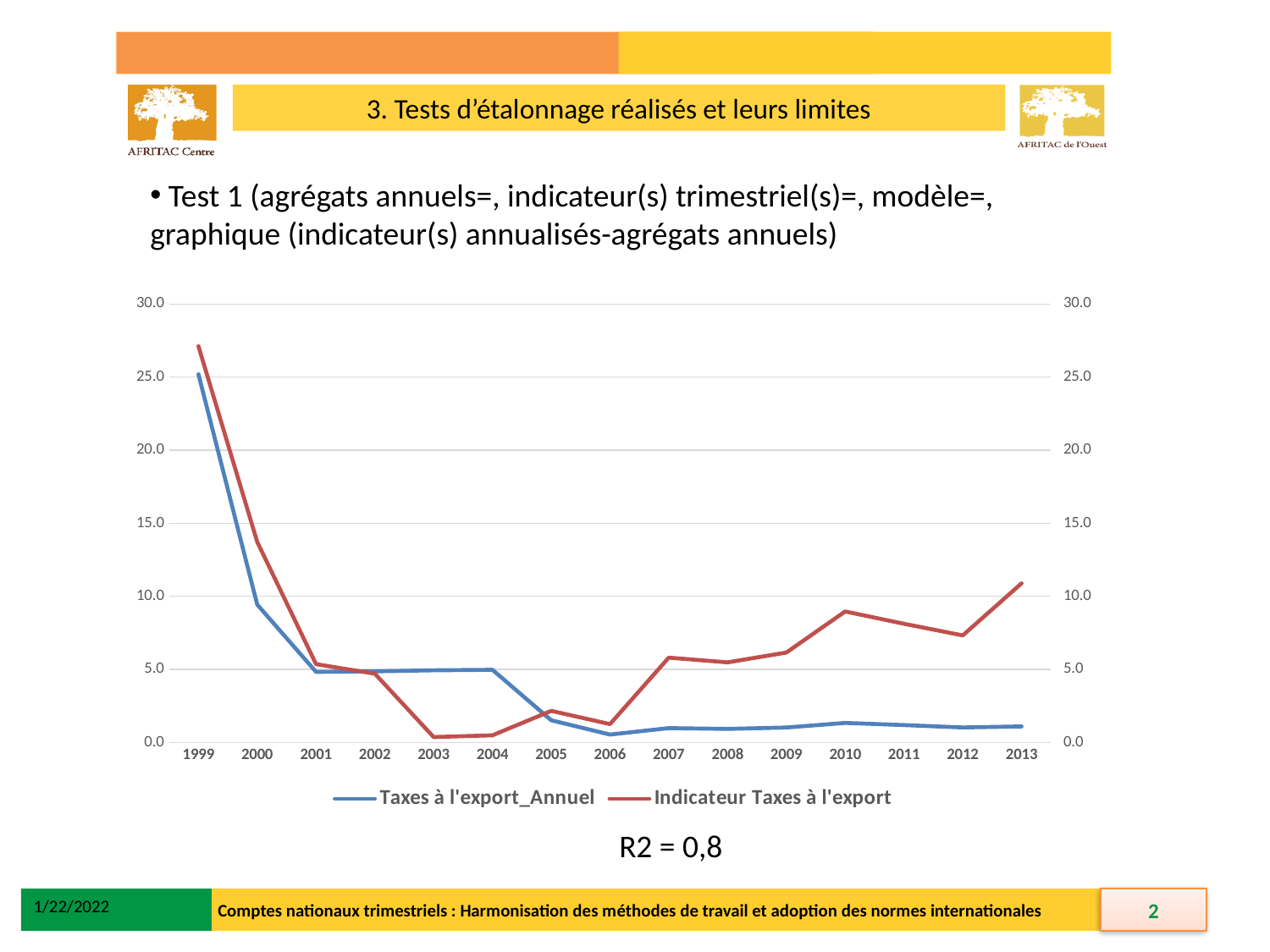
How many years are shown on the x axis? 15 In 2013, which series has the larger value, Taxes à l'export_Annuel or Indicateur Taxes à l'export? Indicateur Taxes à l'export Is the value for Indicateur Taxes à l'export in 2003 greater or less than 5.0? less Does the Taxes à l'export_Annuel series rise or fall from 1999 to 2006? fall Is the value for Indicateur Taxes à l'export in 2013 greater or less than 10.0? greater In which year does the Indicateur Taxes à l'export series reach its highest value? 1999 In which year does the Taxes à l'export_Annuel series reach its highest value? 1999 What R2 value is printed below the chart? R2 = 0,8 Is the value for Taxes à l'export_Annuel in 1999 greater or less than 20.0? greater How many series does the legend list? 2 What kind of chart is shown on the slide? line chart In which year is the Taxes à l'export_Annuel series at its lowest? 2006